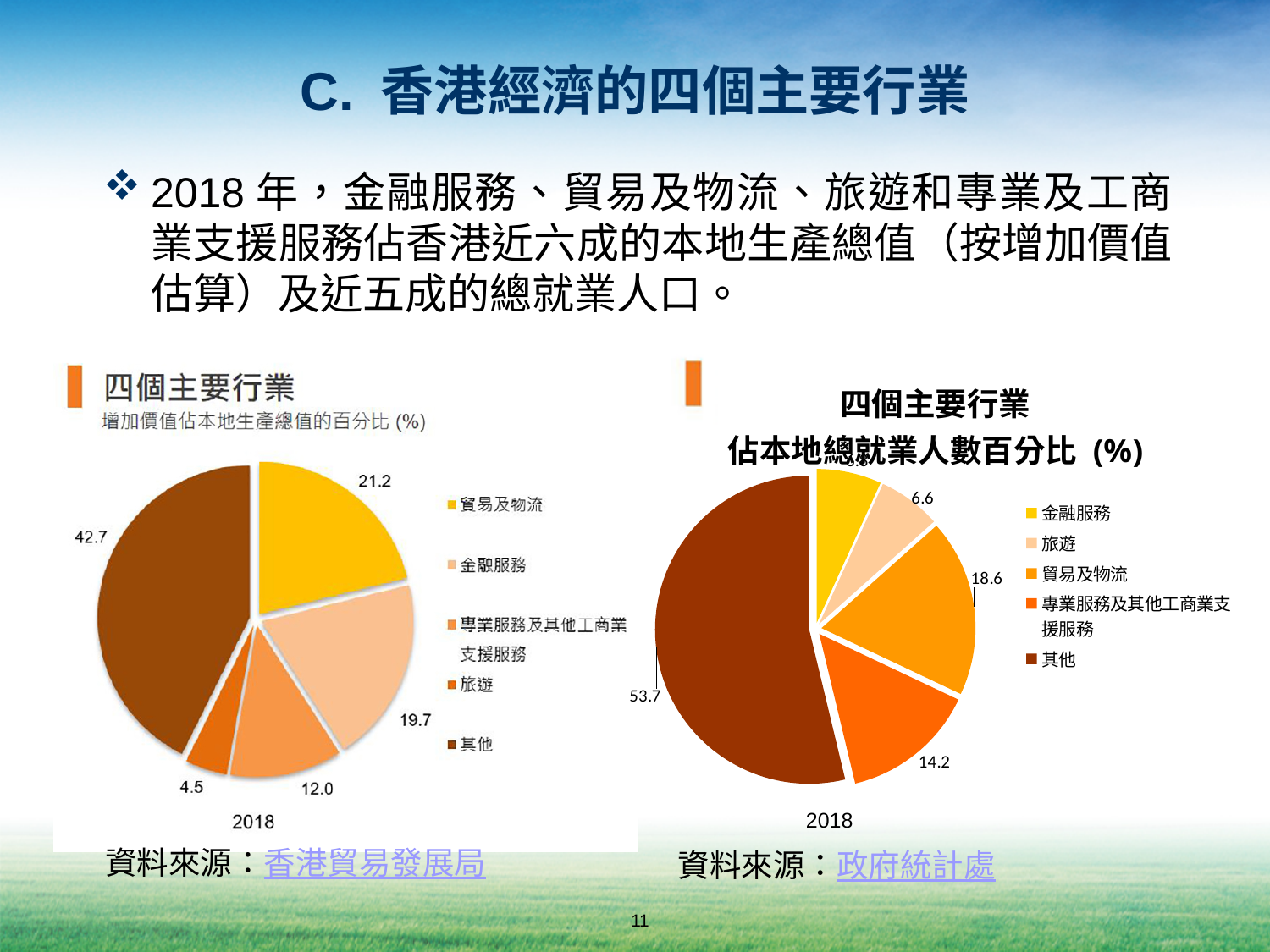
In the left chart (增加價值佔本地生產總值的百分比), what is the value for 貿易及物流? 21.2 In the left chart (增加價值佔本地生產總值的百分比), what is the value for 旅遊? 4.5 In the right chart (佔本地總就業人數百分比), what is the value for 貿易及物流? 18.6 What type of chart is the left chart (增加價值佔本地生產總值的百分比)? Pie chart In the right chart (佔本地總就業人數百分比), what is the value for 其他? 53.7 In the left chart (增加價值佔本地生產總值的百分比), which category has the smallest slice? 旅遊 In the left chart (增加價值佔本地生產總值的百分比), what is the difference between 貿易及物流 and 金融服務? 1.5 In the right chart (佔本地總就業人數百分比), which is larger, 貿易及物流 or 專業服務及其他工商業支援服務? 貿易及物流 How many slices does the right chart (佔本地總就業人數百分比) have? 5 In the right chart (佔本地總就業人數百分比), what is the difference between 貿易及物流 and 專業服務及其他工商業支援服務? 4.4 How many entries does the legend of the right chart (佔本地總就業人數百分比) list? 5 In the left chart (增加價值佔本地生產總值的百分比), which category has the largest slice? 其他